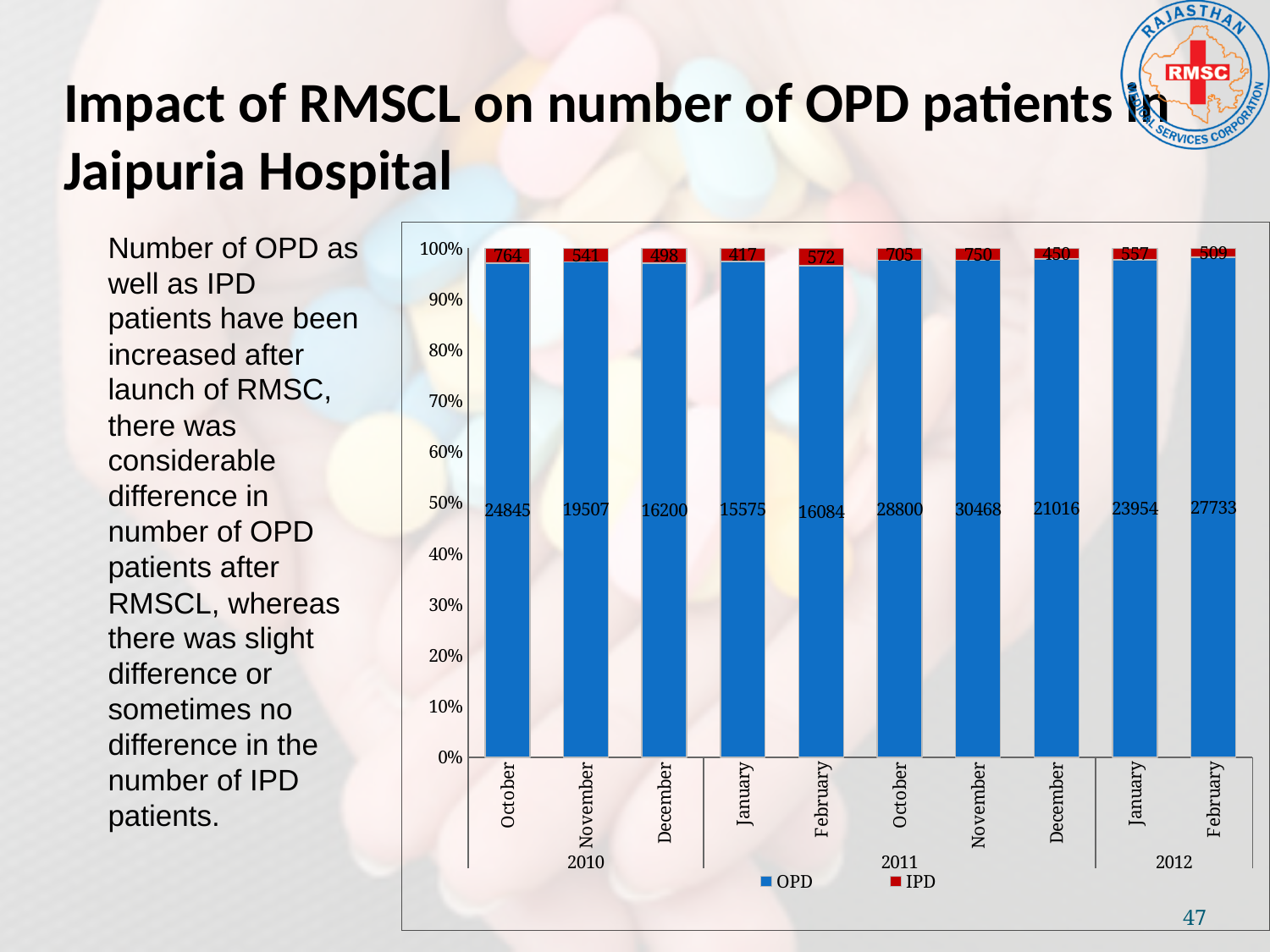
What is the total of OPD and IPD for October 2010? 25609 Which is larger, the OPD value for February 2012 or the OPD value for February 2011? February 2012 What is the difference between the OPD values for November 2011 and October 2011? 1668 How many bars (months) are shown in the chart? 10 Which month has the highest OPD value? November 2011 What is the IPD value for October 2010? 764 Which month has the lowest OPD value? January 2011 What is the OPD value for November 2011? 30468 Which month has the lowest IPD value? January 2011 How many series does the legend list? 2 What kind of chart is shown on the slide? Stacked bar chart What is the OPD value for January 2011? 15575